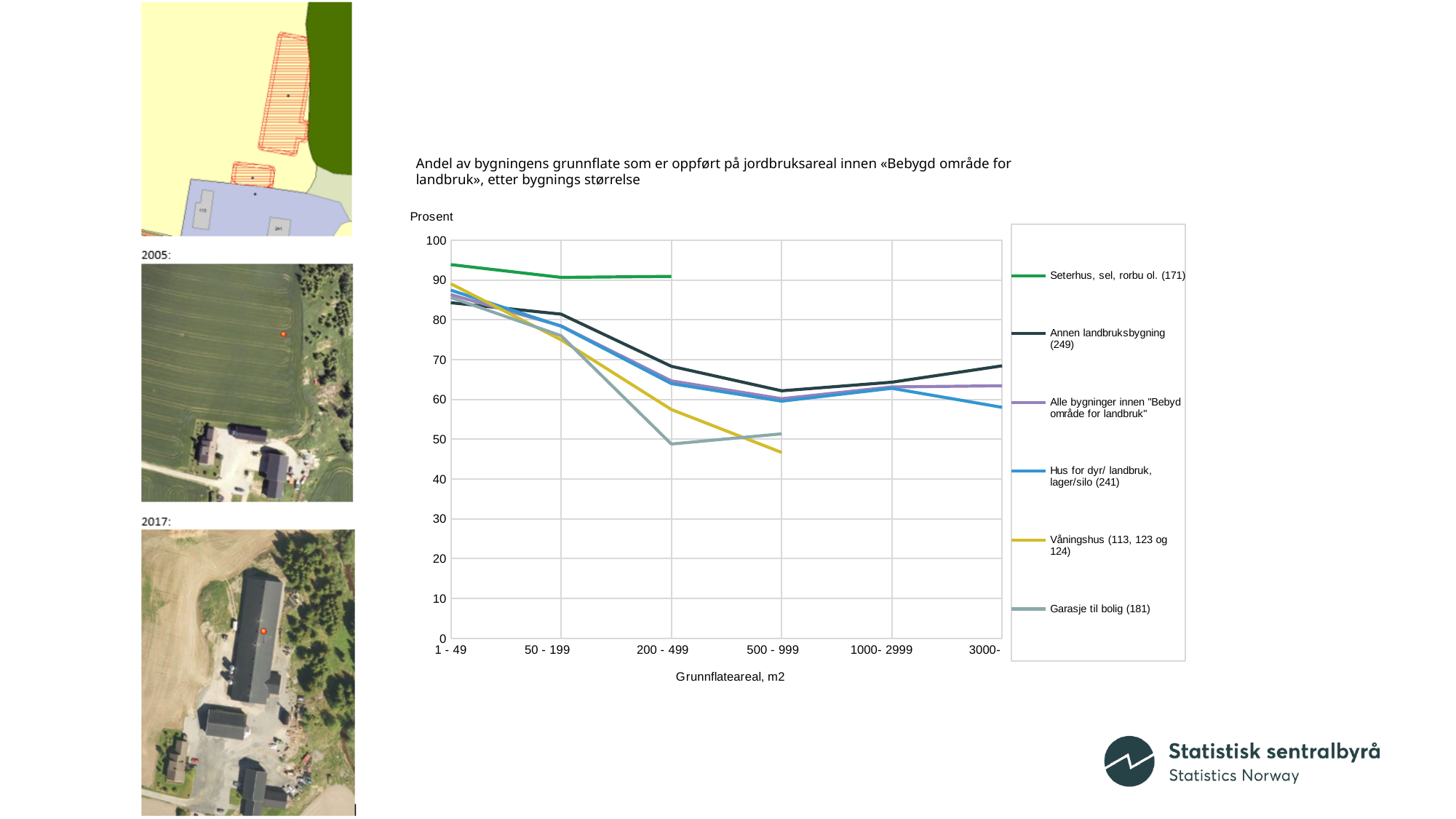
Which series has the lowest value for the 200 - 499 category? Garasje til bolig (181) How many size categories are shown on the x axis? 6 Does the Våningshus (113, 123 og 124) line rise or fall as building size increases along the x axis? fall Is the value for Garasje til bolig (181) at 200 - 499 greater or less than 60? less How many series does the legend list? 6 Is the value for Seterhus, sel, rorbu ol. (171) at 1 - 49 greater or less than 90? greater What is the title of the x axis? Grunnflateareal, m2 At the 3000- category, which is larger: Annen landbruksbygning (249) or Hus for dyr/ landbruk, lager/silo (241)? Annen landbruksbygning (249) What kind of chart is shown on the slide? line chart Which series has the lowest value for the 500 - 999 category? Våningshus (113, 123 og 124) Is the value for Våningshus (113, 123 og 124) at 500 - 999 greater or less than 50? less Which series has the highest value for the 1 - 49 category? Seterhus, sel, rorbu ol. (171)